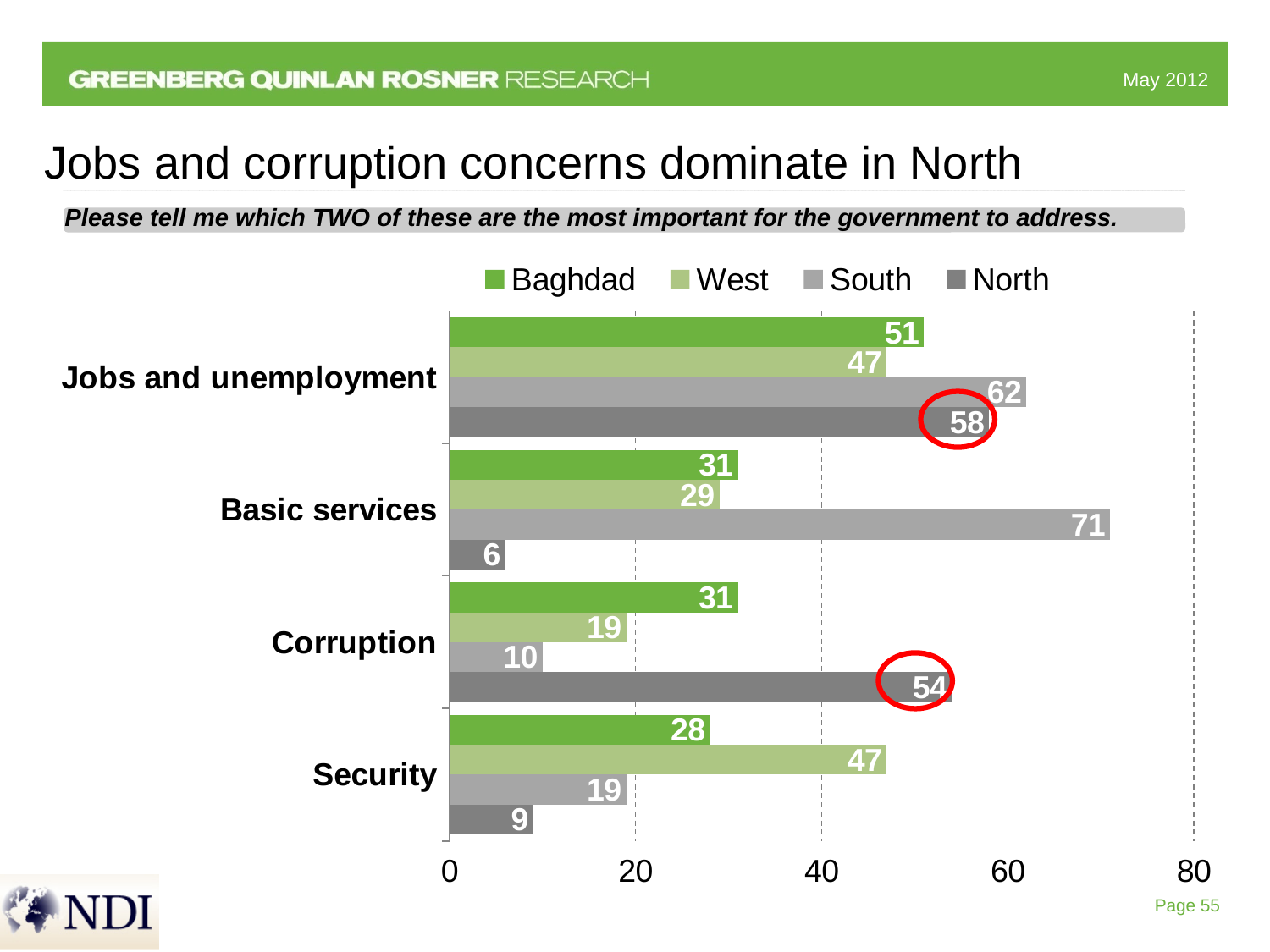
What kind of chart is shown on the slide? Bar chart Which two data labels are circled in red on the chart? 58 and 54 What is the difference between the South and North values for Basic services? 65 Which region has the lowest value for Basic services? North Which region has the highest value for Jobs and unemployment? South What is the value for West in the Security category? 47 How many categories are shown on the chart? 4 What is the value for North in the Corruption category? 54 What is the value for South in the Basic services category? 71 Which is larger for Corruption: the Baghdad value or the West value? Baghdad What is the value for North in the Jobs and unemployment category? 58 How many series does the legend list? 4